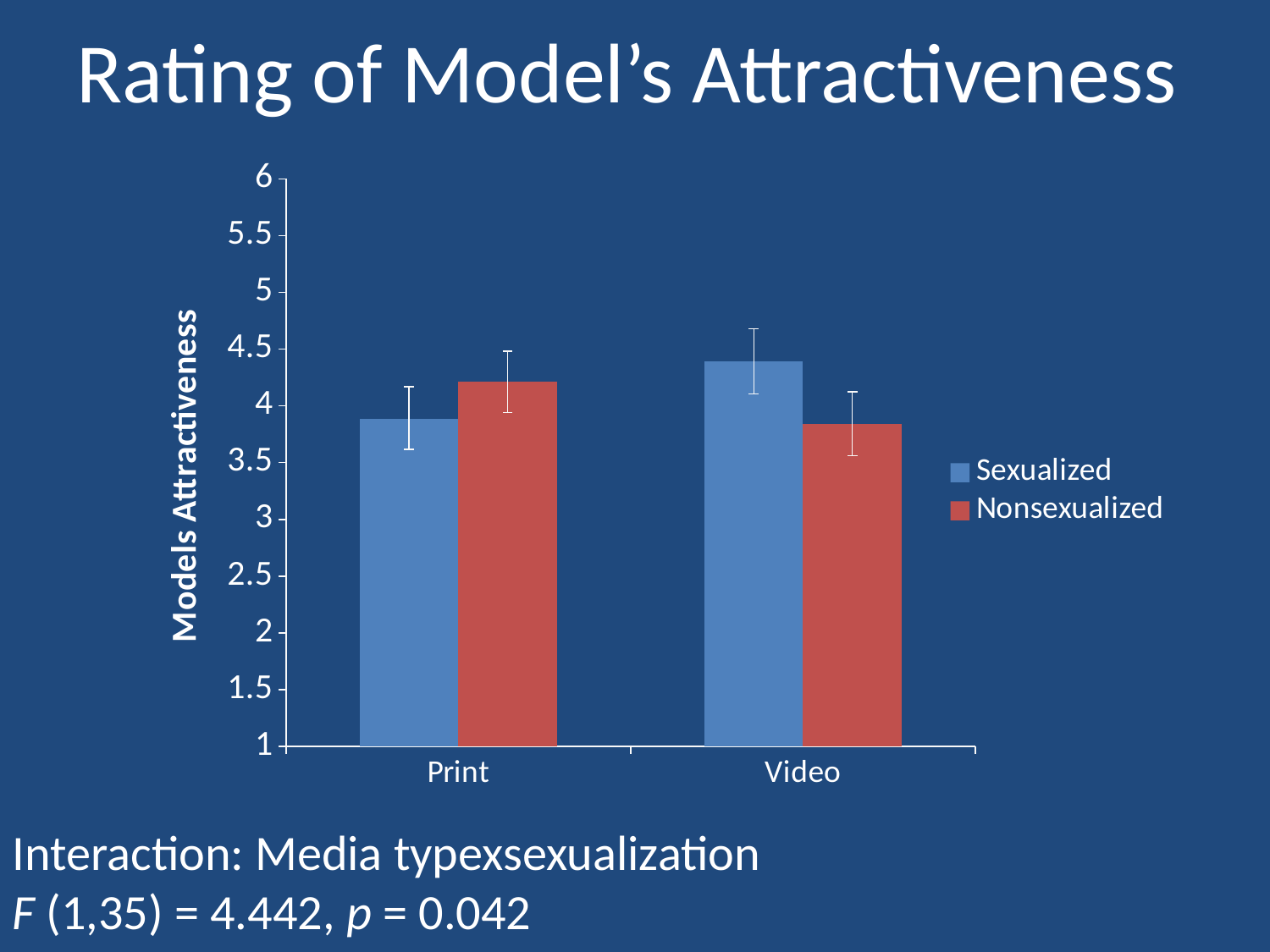
For Video, which is larger: the Sexualized or the Nonsexualized value? Sexualized Is the Sexualized value for Video greater or less than 4.5? less How many categories are shown on the x axis? 2 For Print, which is larger: the Sexualized or the Nonsexualized value? Nonsexualized Is the Nonsexualized value for Print greater or less than 4? greater Which bar is the highest in the chart? Sexualized for Video What is the title of the vertical axis? Models Attractiveness How many series does the legend list? 2 What kind of chart is shown on the slide? bar chart Is the Nonsexualized value for Video greater or less than 4? less Which series is shown in blue according to the legend? Sexualized